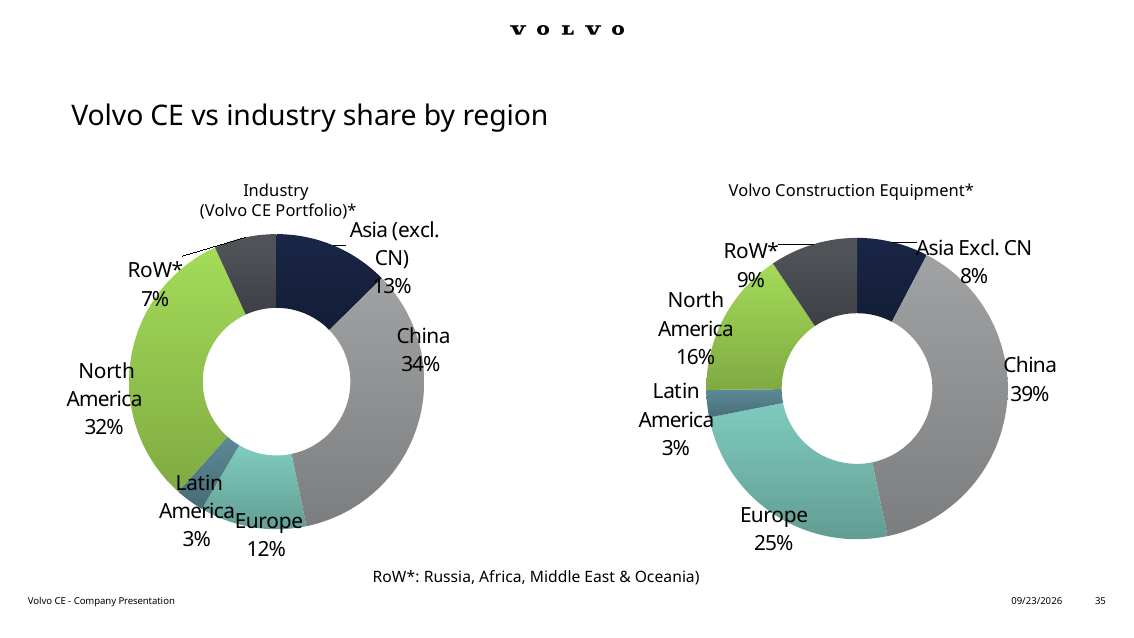
According to the footnote, what does RoW* stand for? Russia, Africa, Middle East & Oceania In the Industry (Volvo CE Portfolio) chart, which region has the smallest share? Latin America In the Volvo Construction Equipment chart, which region has the largest share? China What type of chart is the Industry (Volvo CE Portfolio) chart? Doughnut chart In the Industry (Volvo CE Portfolio) chart, what share does China have? 34% How many regions are shown in the Volvo Construction Equipment chart? 6 What is the difference between China's share in the Volvo Construction Equipment chart and China's share in the Industry (Volvo CE Portfolio) chart? 5% Which is larger: North America's share in the Industry (Volvo CE Portfolio) chart or North America's share in the Volvo Construction Equipment chart? Industry (Volvo CE Portfolio) In the Volvo Construction Equipment chart, what share does Europe have? 25% In the Industry (Volvo CE Portfolio) chart, what share does RoW* have? 7% In the Industry (Volvo CE Portfolio) chart, what is the combined share of Europe and Latin America? 15% In the Volvo Construction Equipment chart, what share does North America have? 16%